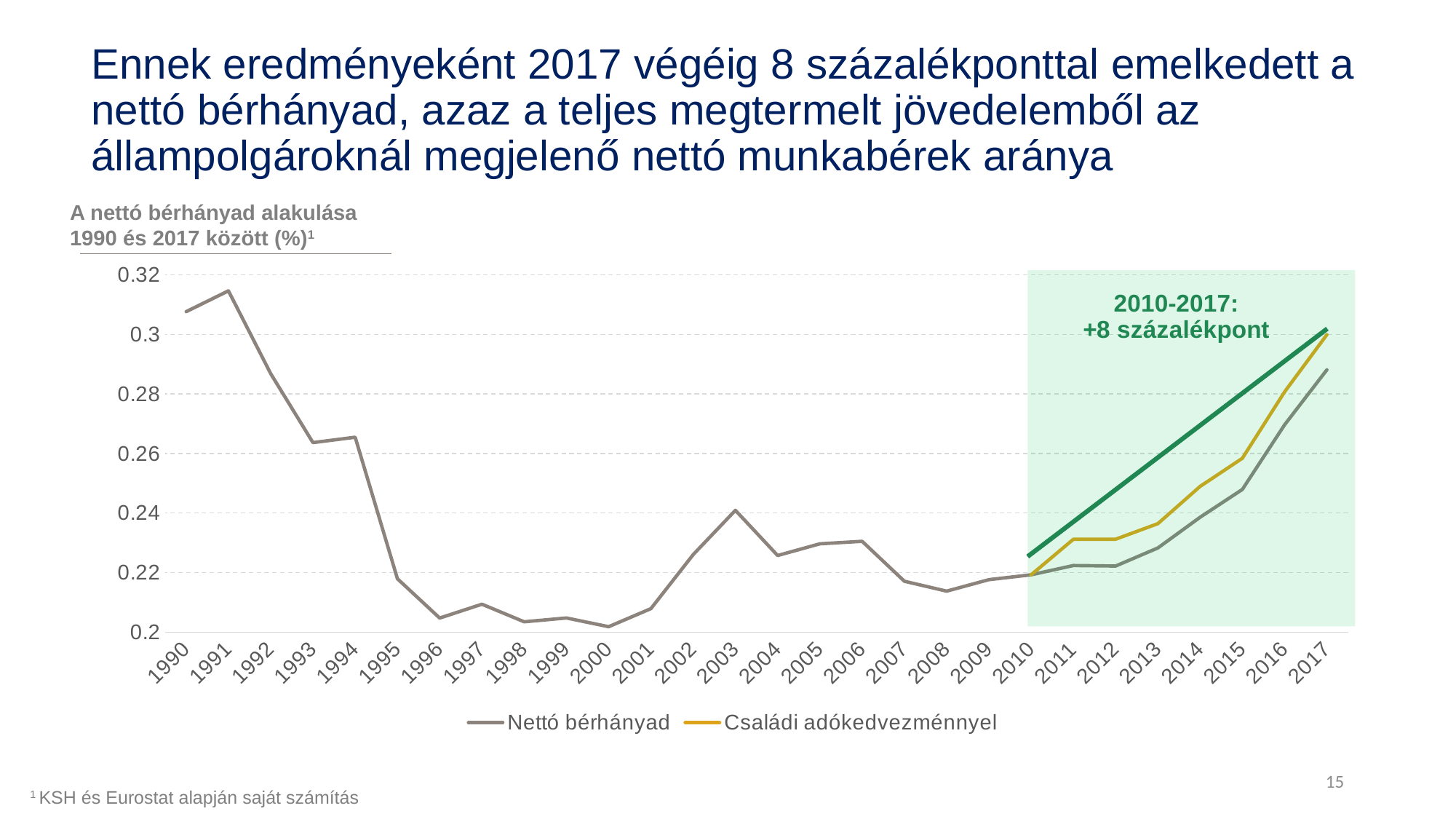
Which is larger for Nettó bérhányad: the value in 1990 or the value in 2017? 1990 What change does the annotation in the shaded area state for 2010-2017? +8 százalékpont Is the Nettó bérhányad value for 1993 greater or less than 0.24? greater In which year does the Nettó bérhányad series reach its highest value? 1991 Is the Nettó bérhányad value for 2017 greater or less than 0.28? greater Is the Nettó bérhányad value for 1991 greater or less than 0.3? greater How many years are plotted along the x axis? 28 Do the values of Nettó bérhányad rise or fall between 2010 and 2017? rise What kind of chart is shown on the slide? line chart In 2015, which series has the higher value: Nettó bérhányad or Családi adókedvezménnyel? Családi adókedvezménnyel How many series does the legend list? 2